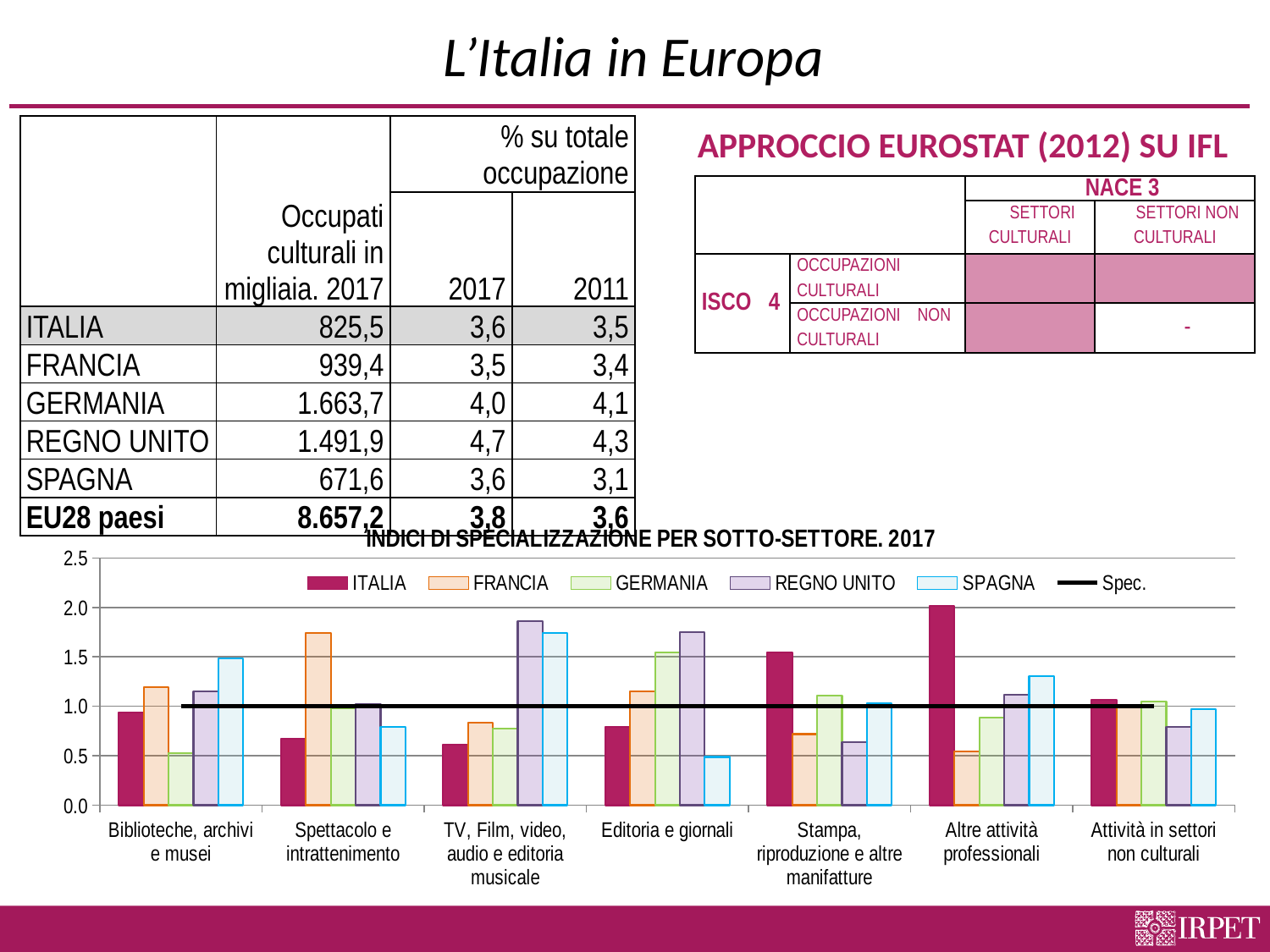
In the 'Editoria e giornali' category, which country has the lowest bar? SPAGNA At what value on the y axis does the horizontal 'Spec.' line sit? 1.0 In the 'Altre attività professionali' category, which country has the highest bar? ITALIA Is the value for ITALIA in 'Altre attività professionali' greater or less than 1.5? greater In the 'Biblioteche, archivi e musei' category, which country has the lowest bar? GERMANIA How many entries does the chart's legend list? 6 In 'TV, Film, video, audio e editoria musicale', which is larger: the value for REGNO UNITO or for ITALIA? REGNO UNITO In 'Stampa, riproduzione e altre manifatture', which is larger: the value for ITALIA or for FRANCIA? ITALIA In the 'Spettacolo e intrattenimento' category, which country has the highest bar? FRANCIA Is the value for GERMANIA in 'Biblioteche, archivi e musei' greater or less than 1.0? less What kind of chart is 'INDICI DI SPECIALIZZAZIONE PER SOTTO-SETTORE. 2017'? Bar chart How many sub-sector categories are shown on the x axis of the chart? 7